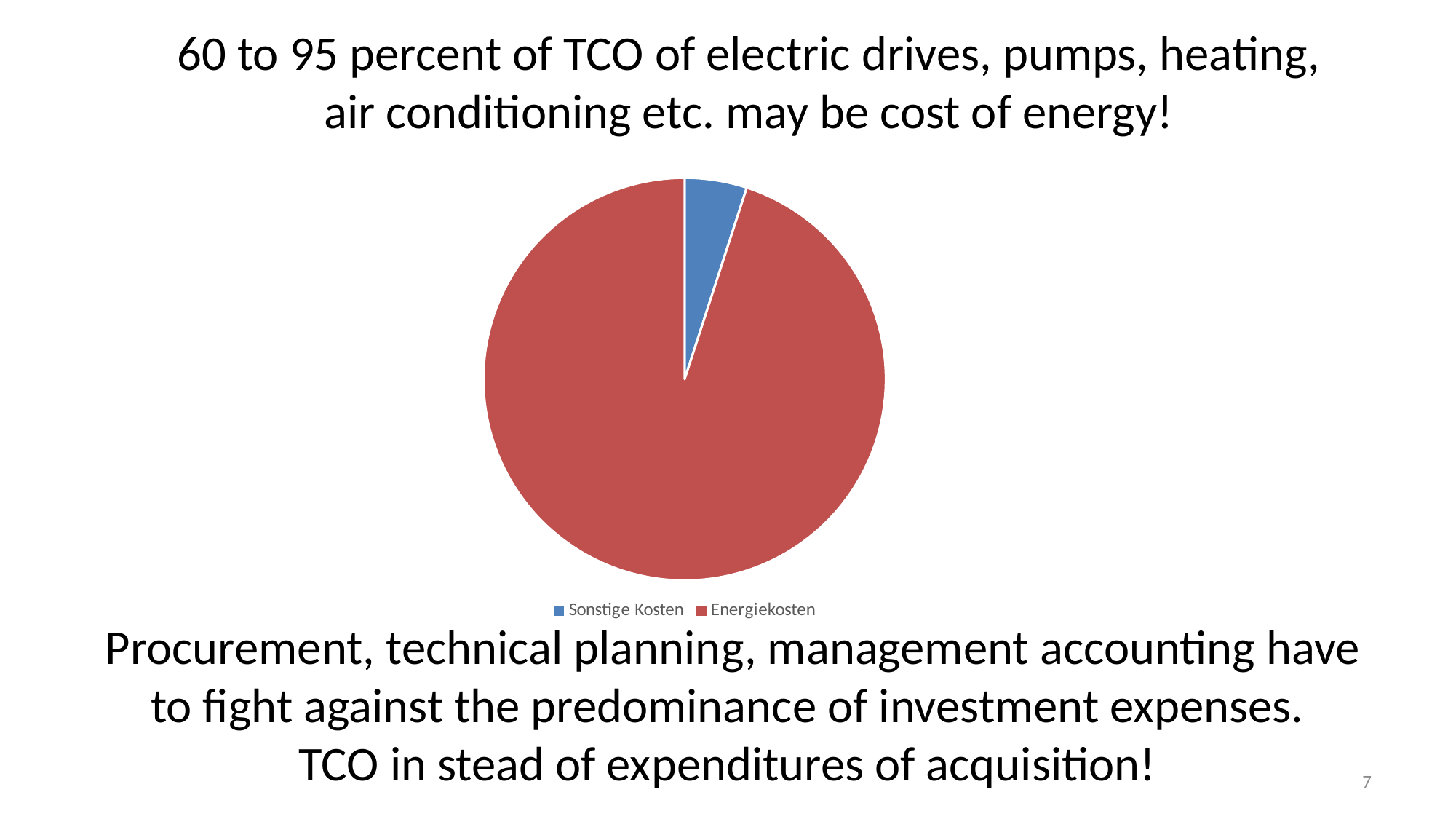
Which category has the largest slice in the pie chart? Energiekosten Which category has the smallest slice in the pie chart? Sonstige Kosten How many entries does the legend of the pie chart list? 2 What colour is the Energiekosten slice in the pie chart? red What colour is the Sonstige Kosten slice in the pie chart? blue How many slices does the pie chart have? 2 What kind of chart is shown on the slide? pie chart Which slice is larger in the pie chart, Sonstige Kosten or Energiekosten? Energiekosten